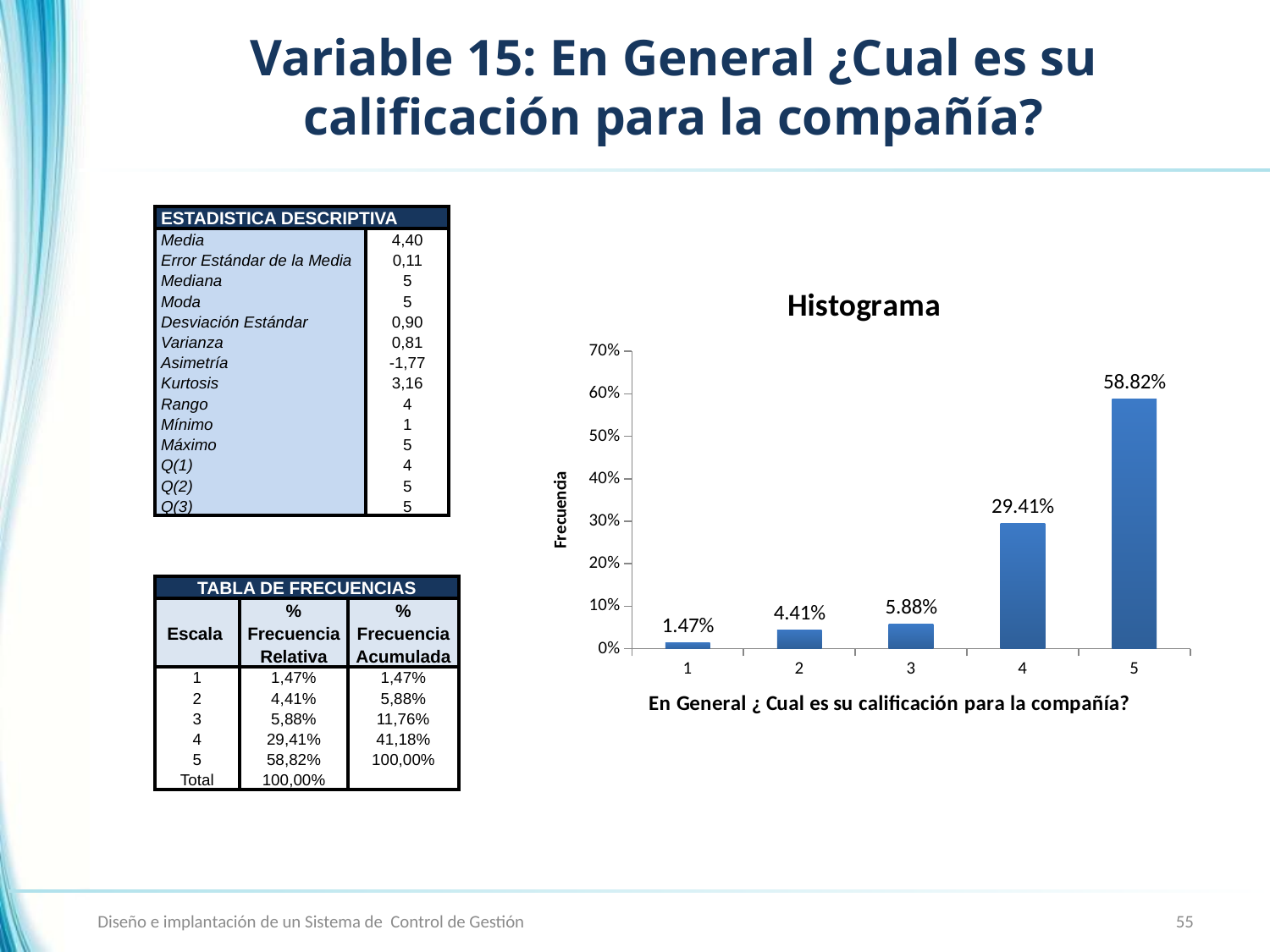
What is the value for category 1 in the Histograma chart? 1.47% How many categories are shown on the x axis of the Histograma chart? 5 Is the value for category 4 in the Histograma chart greater or less than 20%? greater What kind of chart is the Histograma? bar chart Do the values in the Histograma chart rise or fall from category 1 to category 5? rise Which category has the lowest value in the Histograma chart? 1 What is the value for category 3 in the Histograma chart? 5.88% What is the difference between the values for categories 5 and 4 in the Histograma chart? 29.41% Which is larger in the Histograma chart, the value for category 2 or category 3? 3 What is the value for category 5 in the Histograma chart? 58.82% What is the y-axis label of the Histograma chart? Frecuencia Which category has the highest value in the Histograma chart? 5